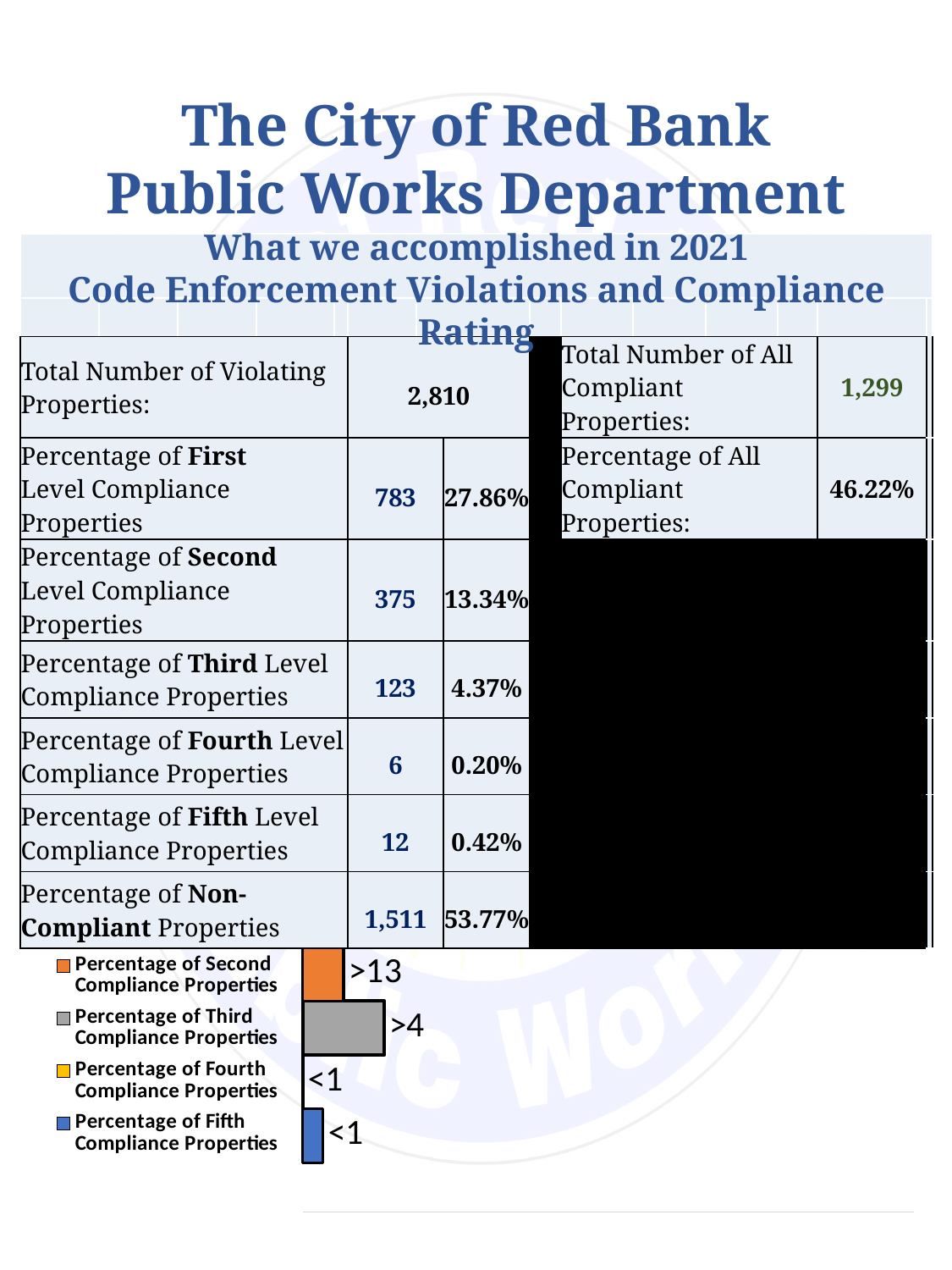
How many series does the legend of the bar chart list? 4 In the bar chart, which bar is longer: Percentage of Second Compliance Properties or Percentage of Third Compliance Properties? Percentage of Third Compliance Properties What colour is the legend marker for Percentage of Second Compliance Properties? orange What colour is the legend marker for Percentage of Fifth Compliance Properties? blue In the bar chart, which series has the longest bar? Percentage of Third Compliance Properties What data label is printed next to the bar for Percentage of Fifth Compliance Properties? <1 What data label is printed next to the bar for Percentage of Second Compliance Properties? >13 What data label is printed next to the bar for Percentage of Third Compliance Properties? >4 In the bar chart, which bar is longer: Percentage of Third Compliance Properties or Percentage of Fifth Compliance Properties? Percentage of Third Compliance Properties What kind of chart is shown at the bottom of the slide? bar chart